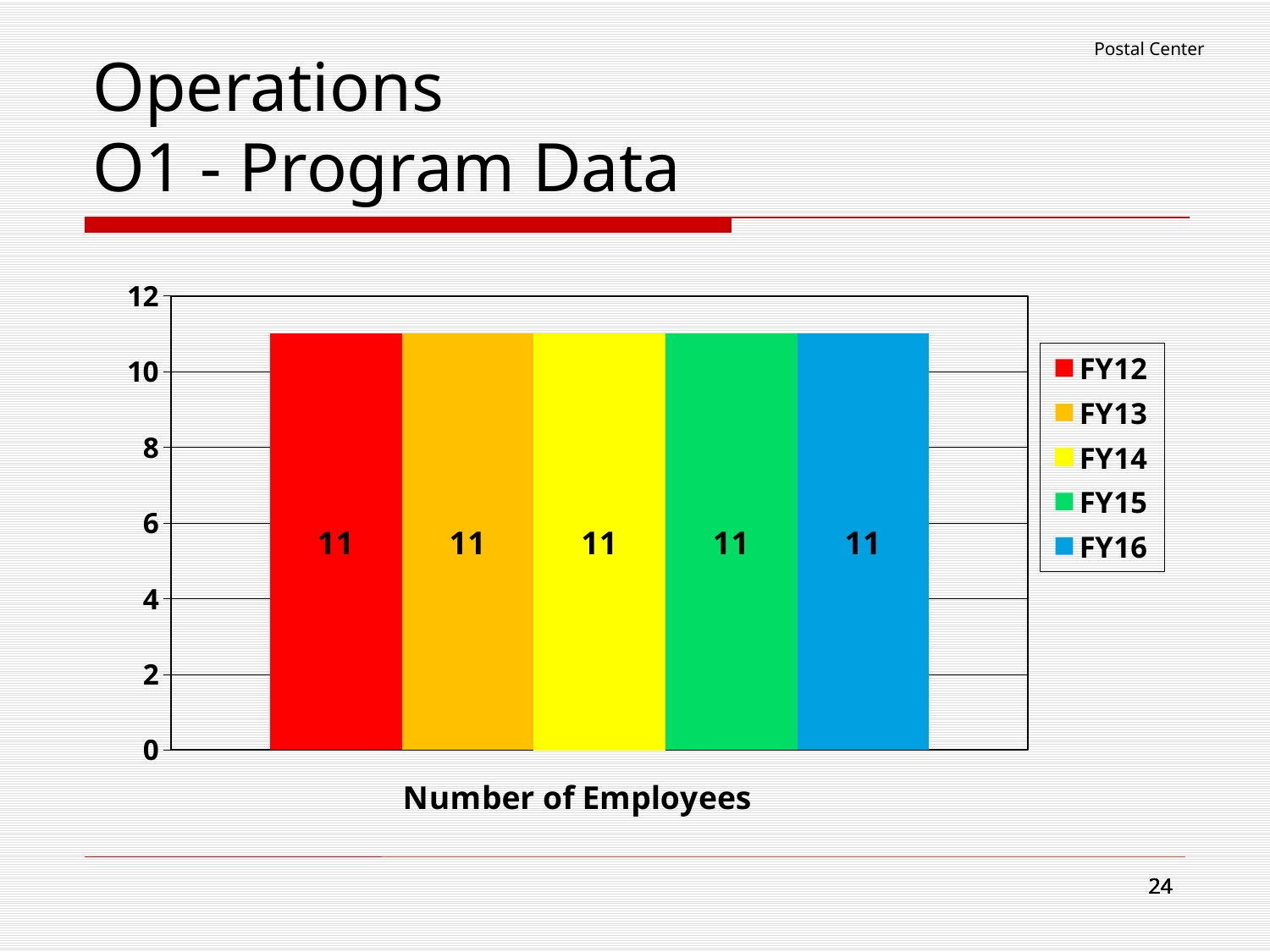
Do the values rise, fall, or stay the same from FY12 to FY16? stay the same What is the difference between the FY13 and FY15 values? 0 What is the highest value shown on the vertical axis? 12 How many series does the legend list? 5 What is the value for FY14 in the Number of Employees chart? 11 What is the value for FY12 in the Number of Employees chart? 11 Which colour represents FY14 in the legend? yellow What is the value for FY16 in the Number of Employees chart? 11 What is the category label shown below the bars? Number of Employees What kind of chart is shown on the slide? bar chart Is the value for FY15 greater or less than 10? greater Is the value for FY12 greater or less than 12? less